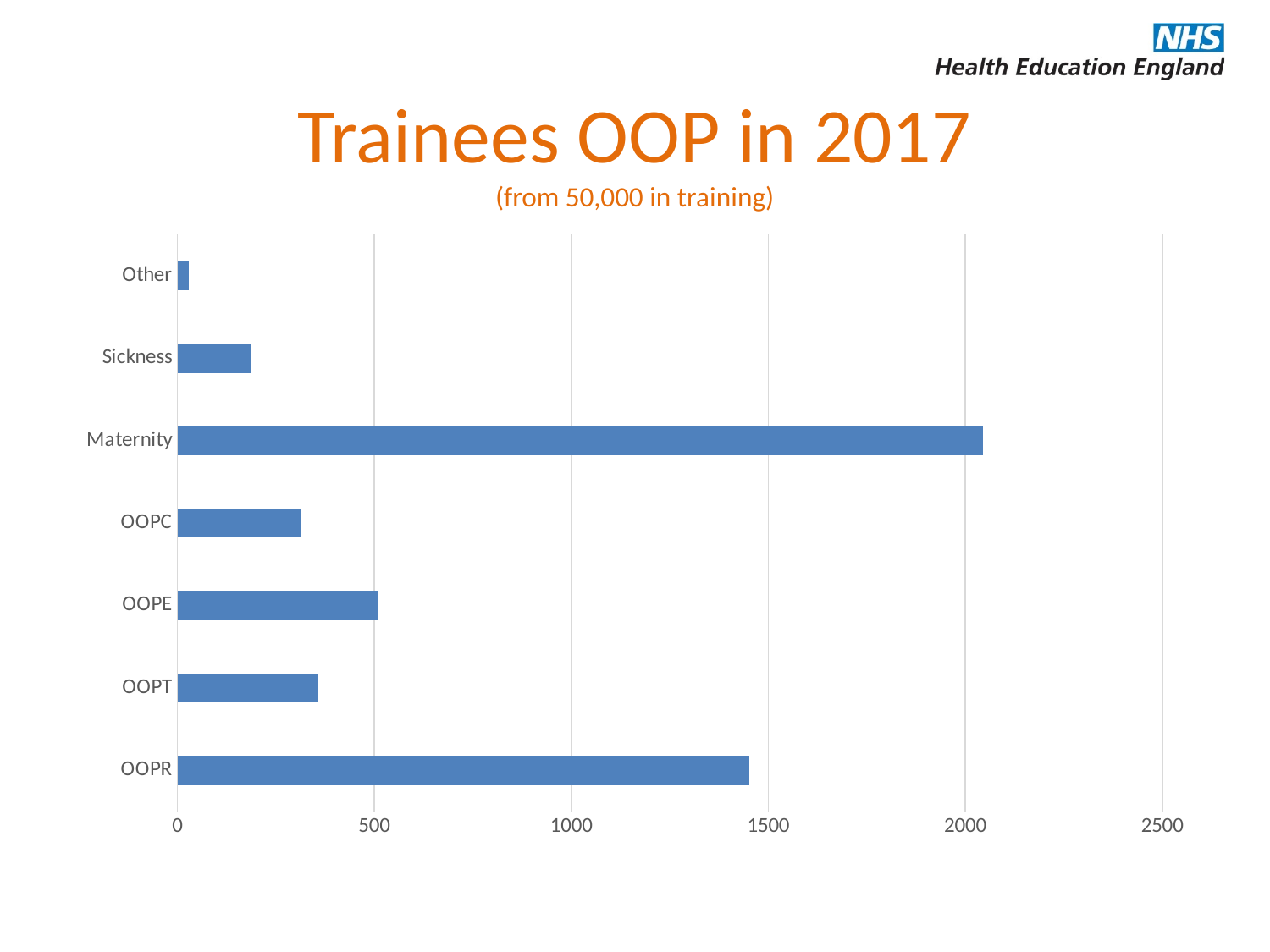
Which category has the lowest value? Other Is the value for OOPR greater or less than 1500? less Which is larger, the value for Sickness or the value for Other? Sickness What kind of chart is shown on the slide? Bar chart Is the value for OOPR greater or less than 1000? greater Which category has the highest value? Maternity Which is larger, the value for OOPE or the value for OOPC? OOPE Is the value for Maternity greater or less than 2000? greater How many categories are plotted in the chart? 7 What is the title of the chart on the slide? Trainees OOP in 2017 Which is larger, the value for OOPR or the value for OOPT? OOPR